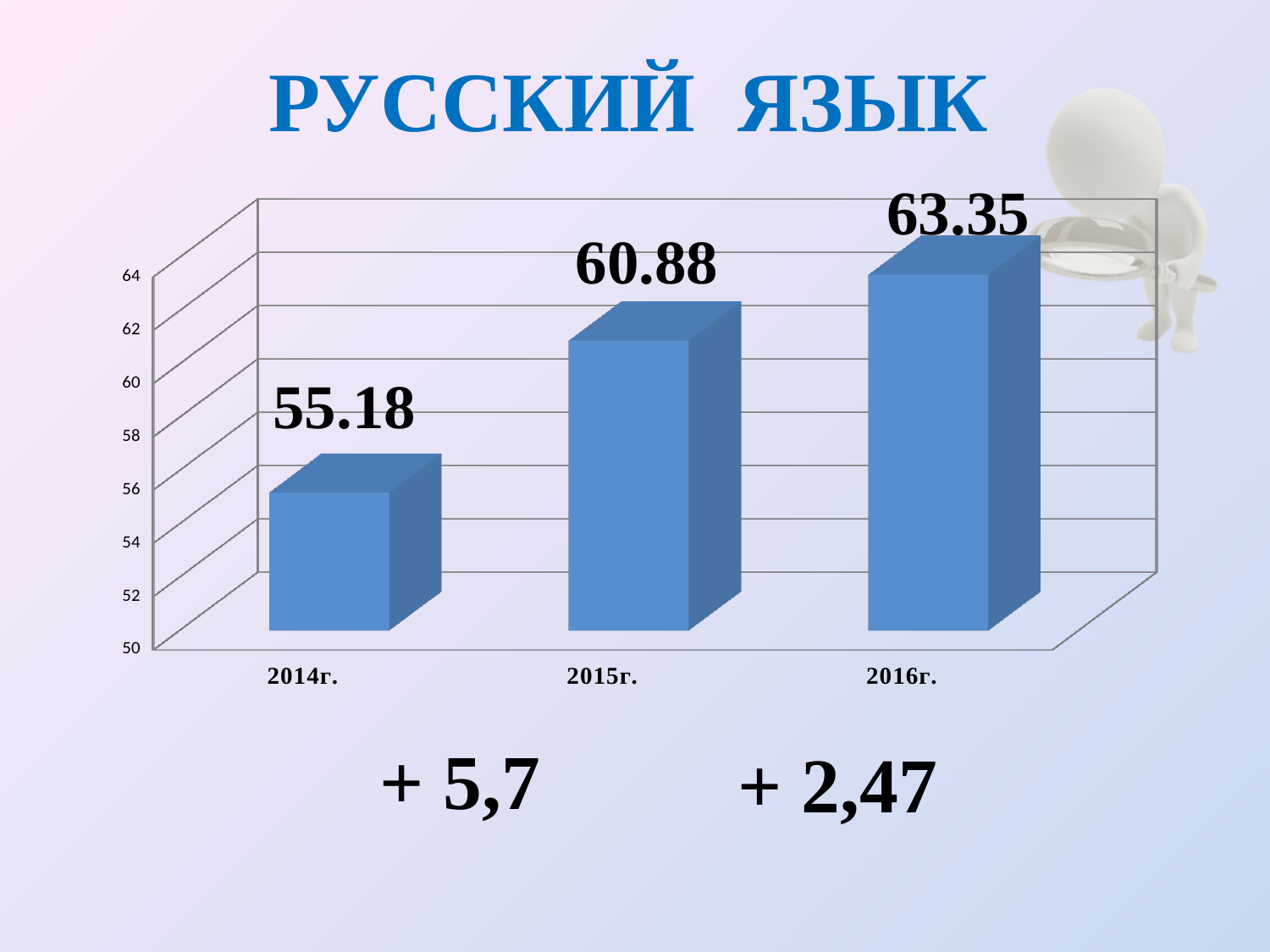
Is the value for 2014г. greater or less than 56? less What is the difference between the values for 2015г. and 2014г.? 5.70 What is the value for 2016г.? 63.35 What is the value for 2014г.? 55.18 What is the difference between the values for 2016г. and 2015г.? 2.47 What is the value for 2015г.? 60.88 Which is larger, the value for 2014г. or the value for 2015г.? 2015г. What kind of chart is shown on the slide? bar chart Do the values rise or fall from 2014г. to 2016г.? rise Which year has the highest value? 2016г. Which year has the lowest value? 2014г. How many years are shown on the chart? 3